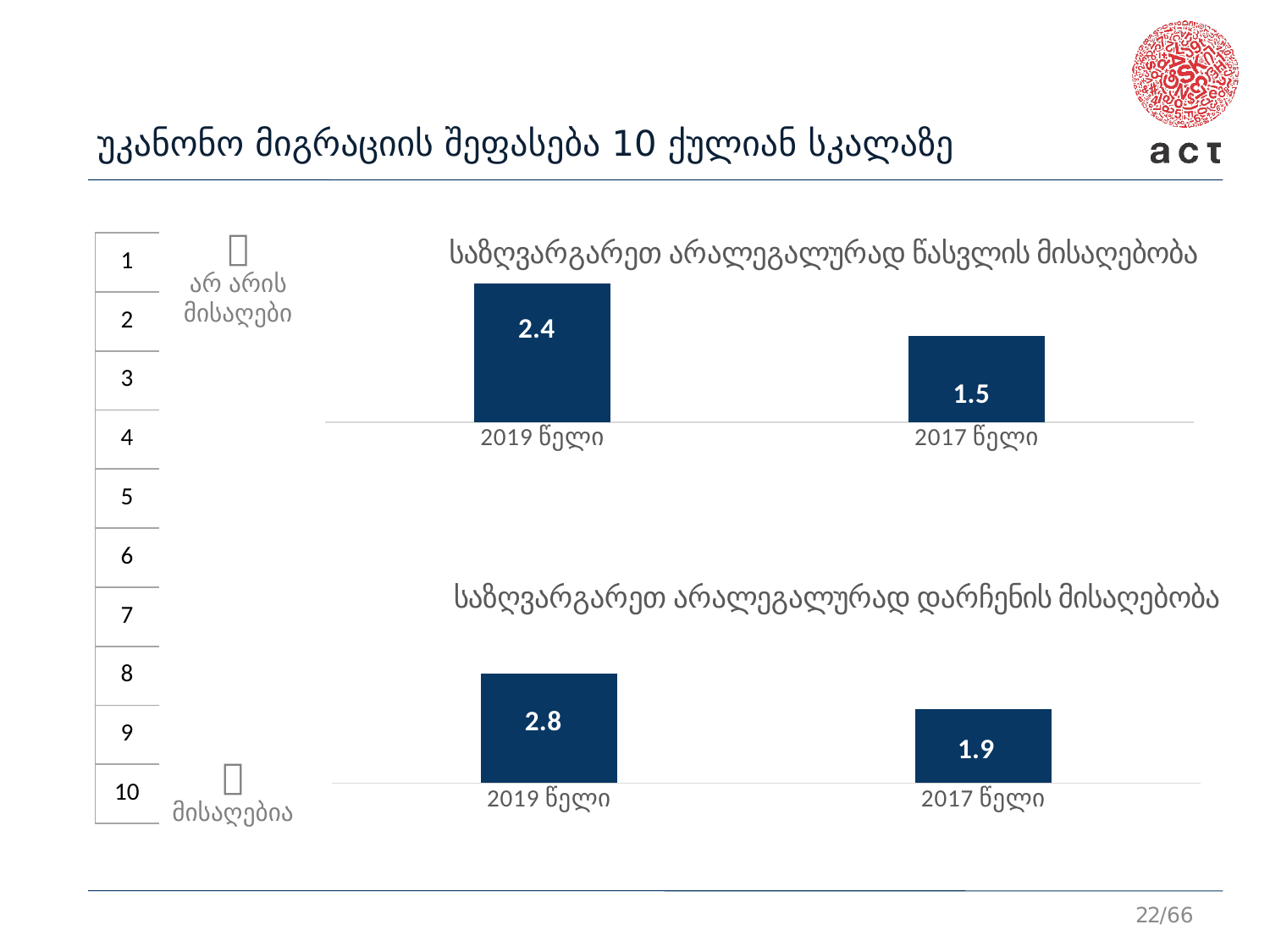
What is the title of the bottom chart? საზღვარგარეთ არალეგალურად დარჩენის მისაღებობა In the top chart, what is the difference between the 2019 წელი and 2017 წელი values? 0.9 In the top chart (საზღვარგარეთ არალეგალურად წასვლის მისაღებობა), what is the value for 2017 წელი? 1.5 What type of chart is the bottom chart? bar chart In the top chart, which year has the higher value? 2019 წელი In the bottom chart, what is the difference between the 2019 წელი and 2017 წელი values? 0.9 Is the 2019 წელი value in the bottom chart larger or smaller than the 2019 წელი value in the top chart? larger How many bars does the top chart show? 2 In the bottom chart (საზღვარგარეთ არალეგალურად დარჩენის მისაღებობა), what is the value for 2019 წელი? 2.8 In the bottom chart, which year has the lower value? 2017 წელი In the top chart (საზღვარგარეთ არალეგალურად წასვლის მისაღებობა), what is the value for 2019 წელი? 2.4 In the bottom chart (საზღვარგარეთ არალეგალურად დარჩენის მისაღებობა), what is the value for 2017 წელი? 1.9